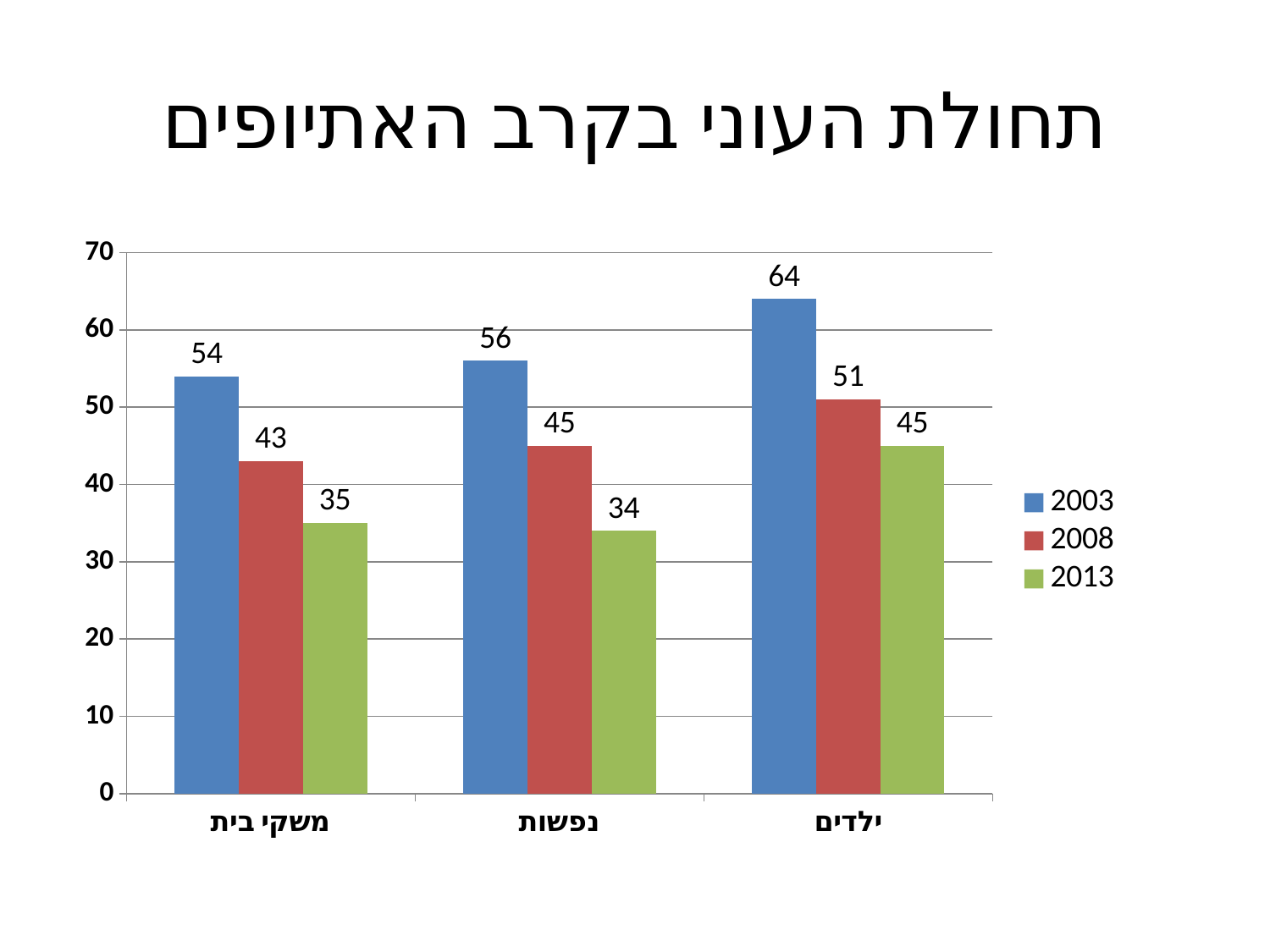
What kind of chart is shown on the slide? Bar chart Which category has the lowest value in the 2013 series? נפשות Do the values for נפשות rise or fall from 2003 to 2013? Fall What is the value for ילדים in the 2003 series? 64 Which is larger: the 2008 value for ילדים or the 2003 value for משקי בית? 2003 value for משקי בית What is the value for נפשות in the 2008 series? 45 How many categories are shown on the x axis? 3 What is the difference between the 2003 and 2013 values for ילדים? 19 What is the value for משקי בית in the 2013 series? 35 What is the difference between the 2003 and 2008 values for משקי בית? 11 Which category has the highest value in the 2003 series? ילדים How many series does the legend list? 3